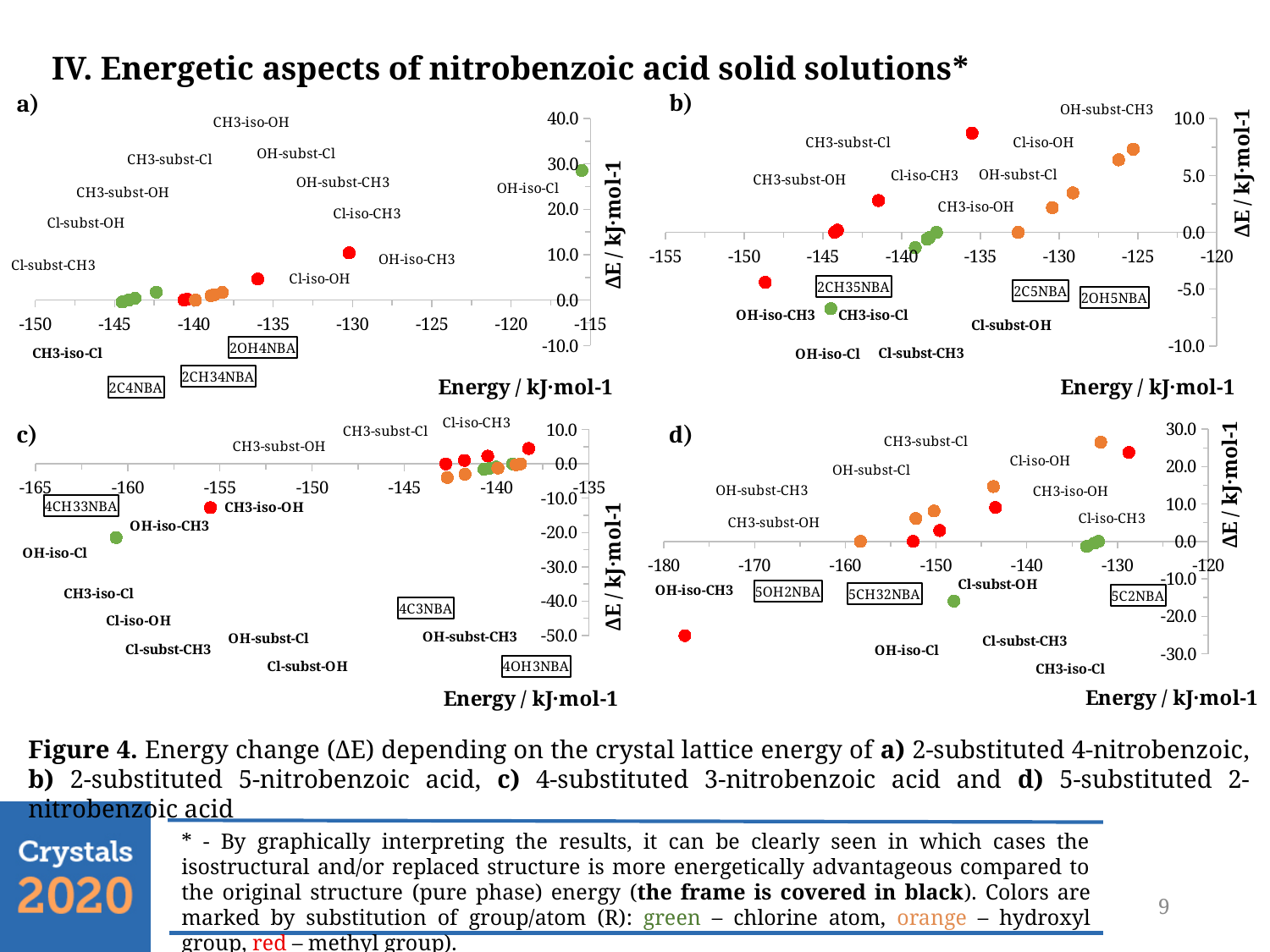
What kind of chart is chart a)? scatter chart How many charts are shown on the slide? 4 In chart b), do the ΔE values generally rise or fall as the energy increases along the x axis? rise In chart d), which point has the lowest ΔE value: the red point near -178 kJ·mol-1 or the green point near -148 kJ·mol-1? the red point near -178 kJ·mol-1 In chart a), is the ΔE value of the green point near -116 kJ·mol-1 greater or less than 20.0? greater In chart d), is the ΔE value of the red point near -178 kJ·mol-1 greater or less than -40.0? greater What is the highest value shown on the y axis of chart a)? 40.0 What is the y-axis title of chart d)? ΔE / kJ·mol-1 In chart c), is the ΔE value of the green point near -160 kJ·mol-1 greater or less than -10.0? less In chart d), do the ΔE values generally rise or fall as the energy increases along the x axis? rise What is the x-axis title of chart b)? Energy / kJ·mol-1